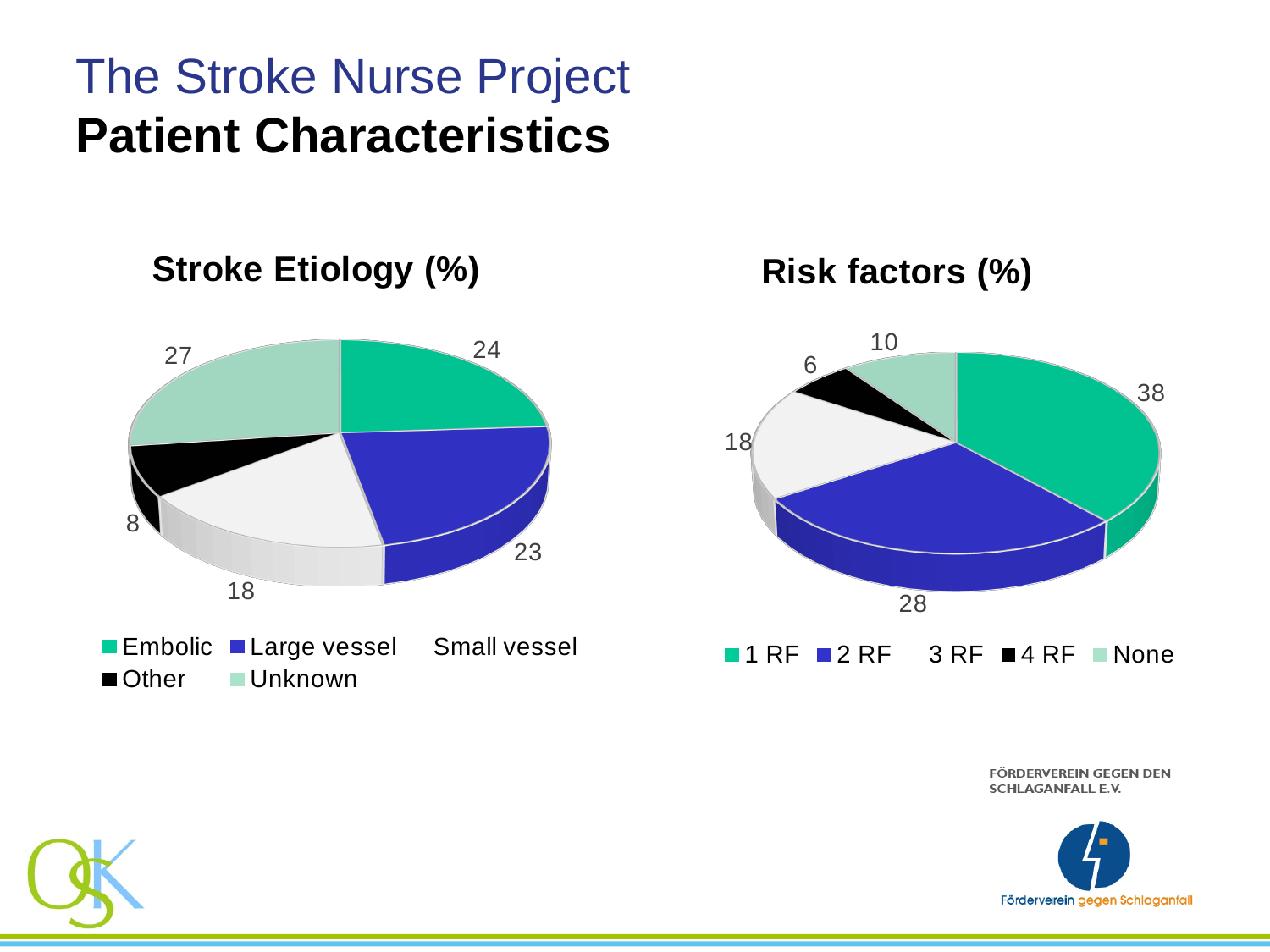
In the Stroke Etiology (%) chart, what is the difference between Embolic and Small vessel? 6 What type of chart is the Risk factors (%) chart? Pie chart In the Risk factors (%) chart, which is larger, 3 RF or None? 3 RF In the Risk factors (%) chart, what is the value for 2 RF? 28 In the Stroke Etiology (%) chart, how many categories are shown? 5 In the Risk factors (%) chart, which category has the smallest share? 4 RF In the Stroke Etiology (%) chart, which category has the largest share? Unknown In the Stroke Etiology (%) chart, what is the value for Unknown? 27 In the Stroke Etiology (%) chart, which category has the smallest share? Other In the Risk factors (%) chart, what is the value for None? 10 In the Stroke Etiology (%) chart, what is the value for Other? 8 In the Risk factors (%) chart, which category has the largest share? 1 RF